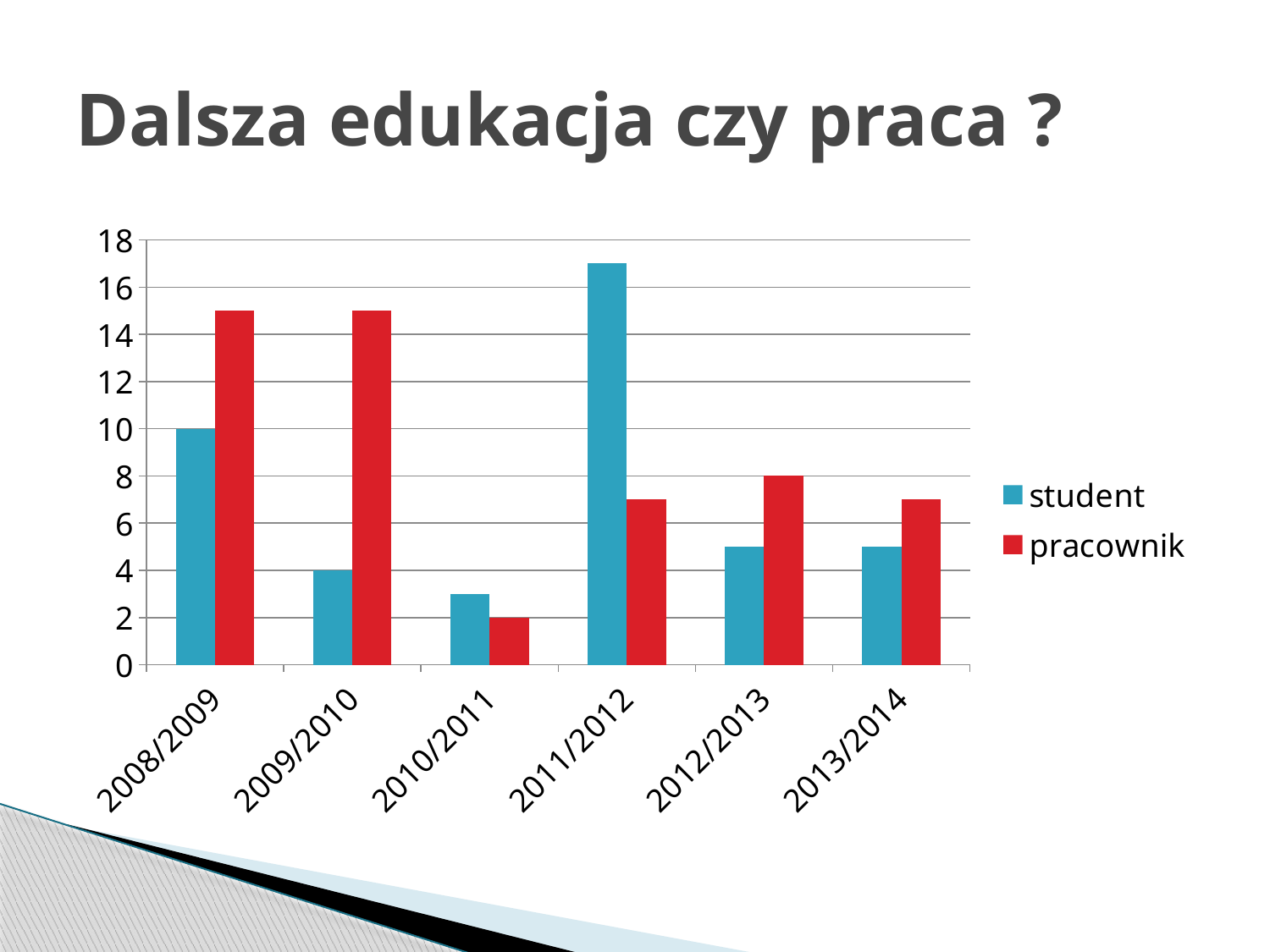
What is the difference between the student values for 2008/2009 and 2009/2010? 6 Is the value for student in 2011/2012 greater or less than 16? greater In which year is the pracownik value lowest? 2010/2011 In which year is the student value highest? 2011/2012 What is the value for pracownik in 2010/2011? 2 What is the value for pracownik in 2012/2013? 8 How many school-year categories are shown on the x axis? 6 What type of chart is shown on the slide? bar chart What is the value for student in 2009/2010? 4 In 2008/2009, which is larger: student or pracownik? pracownik How many series does the legend list? 2 What is the value for student in 2008/2009? 10